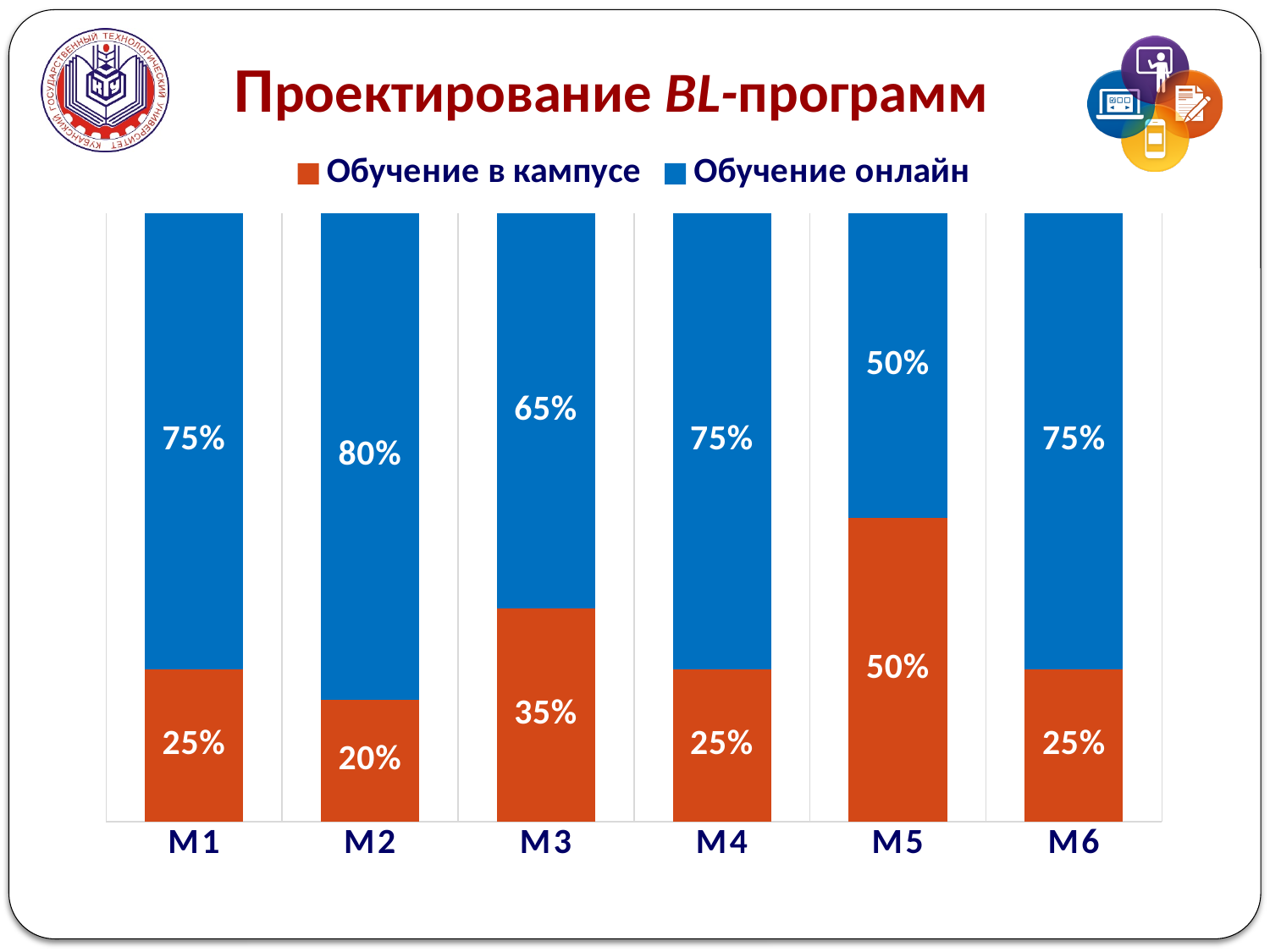
What is the difference between the "Обучение онлайн" values for M2 and M3? 15% What is the value for "Обучение онлайн" for M2? 80% Which is larger: "Обучение в кампусе" for M3 or for M4? M3 Which category has the lowest value for "Обучение онлайн"? M5 What kind of chart is shown on the slide? Stacked bar chart What is the value for "Обучение в кампусе" for M3? 35% What is the value for "Обучение в кампусе" for M5? 50% What is the total of the stacked bar for M1? 100% How many categories are shown on the x axis? 6 How many series does the legend list? 2 Which category has the lowest value for "Обучение в кампусе"? M2 Which category has the highest value for "Обучение в кампусе"? M5